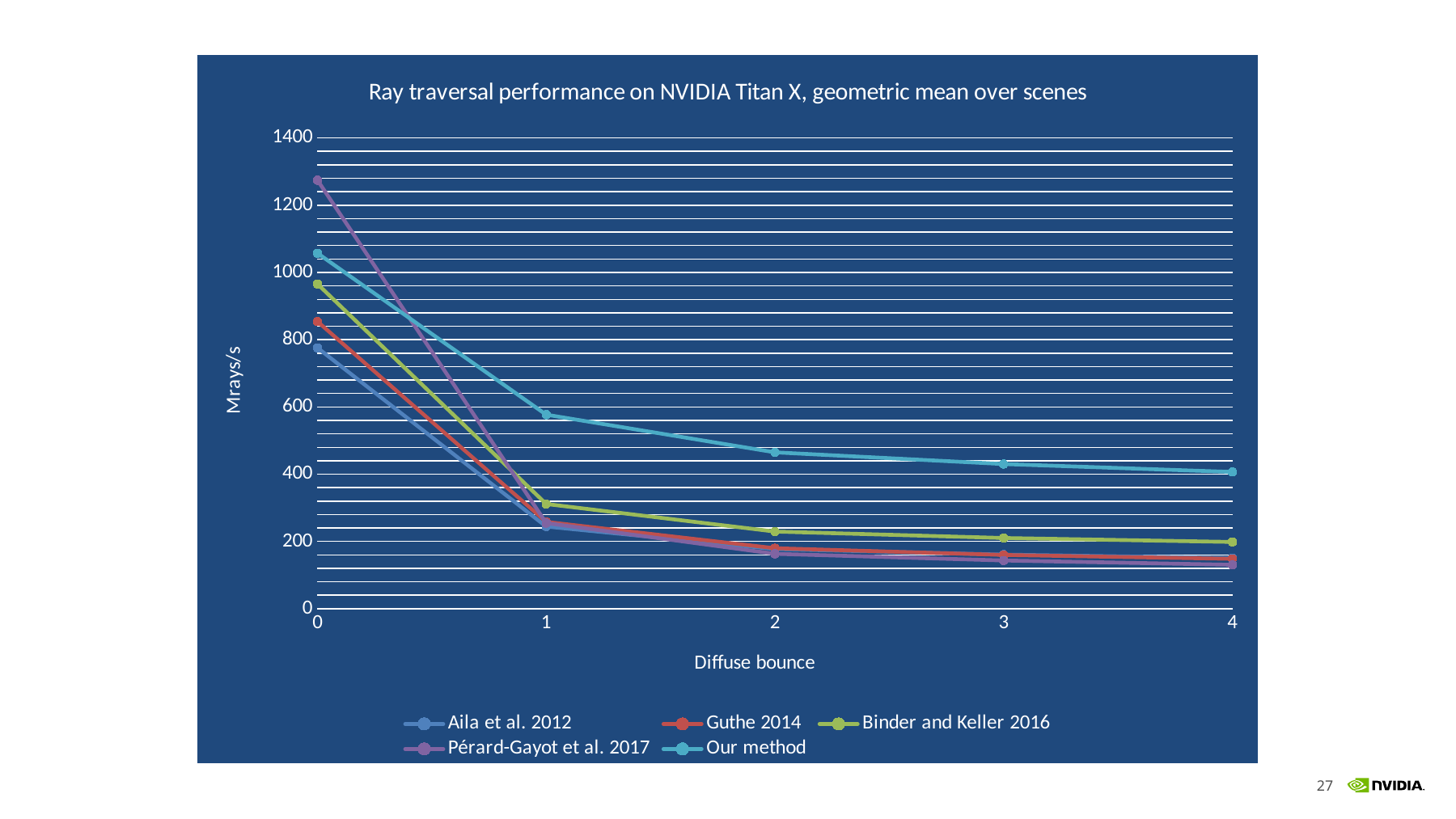
Do the values for Our method rise or fall as the diffuse bounce increases? fall Is the value for Our method at diffuse bounce 4 greater or less than 600? less Is the value for Pérard-Gayot et al. 2017 at diffuse bounce 0 greater or less than 1200? greater Which method has the highest value at diffuse bounce 0? Pérard-Gayot et al. 2017 What is the title of the chart? Ray traversal performance on NVIDIA Titan X, geometric mean over scenes Which method has the lowest value at diffuse bounce 0? Aila et al. 2012 Which method has the highest value at diffuse bounce 4? Our method How many series does the legend list? 5 At diffuse bounce 2, which is larger: the value for Our method or the value for Binder and Keller 2016? Our method How many diffuse bounce values are plotted along the x axis? 5 What kind of chart is shown on the slide? line chart What is the label of the y axis? Mrays/s